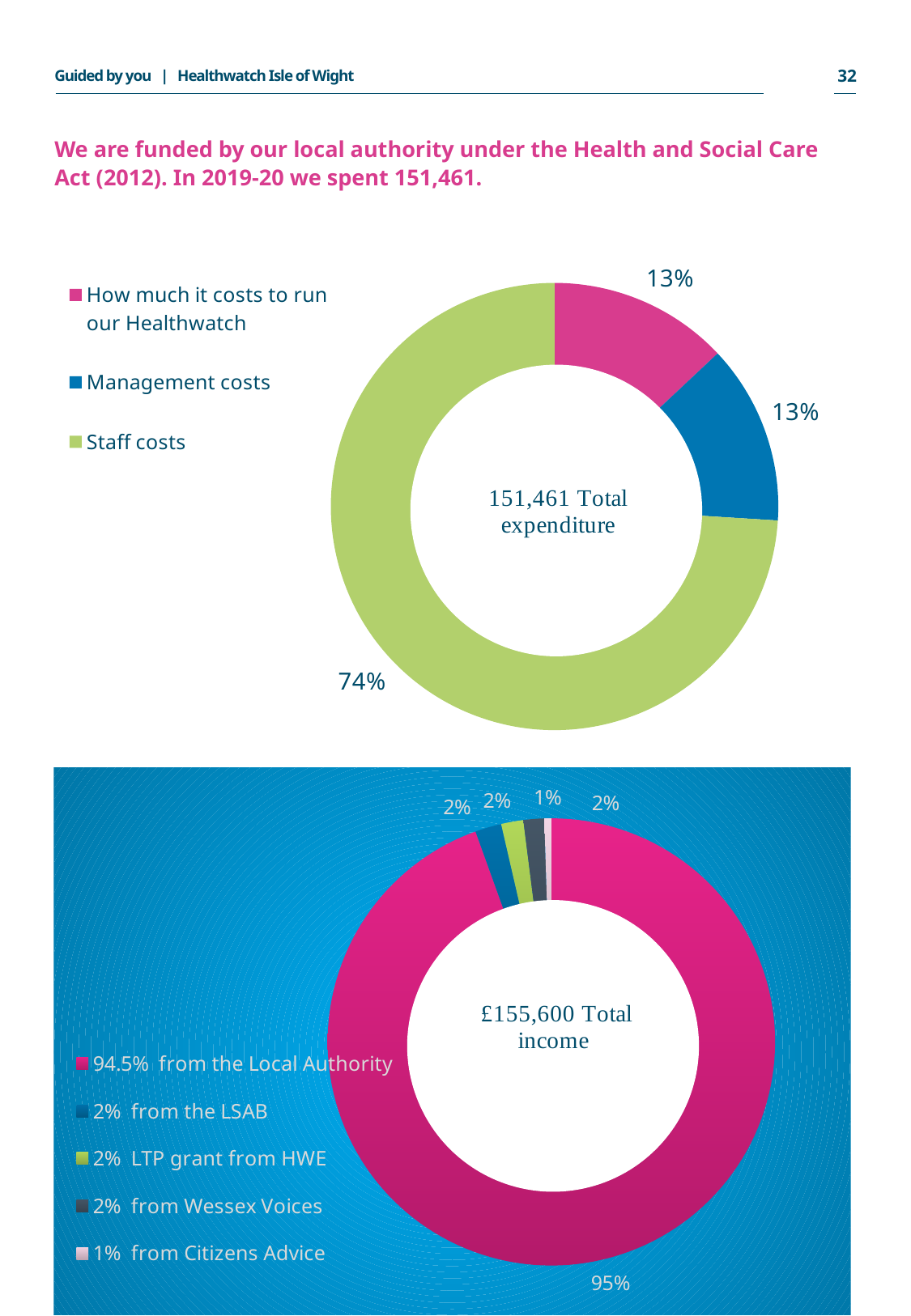
In the bottom chart (£155,600 Total income), which source provides the smallest share of income? Citizens Advice In the top chart (151,461 Total expenditure), how many categories does the legend list? 3 In the bottom chart (£155,600 Total income), which source provides the largest share of income? Local Authority In the top chart (151,461 Total expenditure), what share of expenditure is Management costs? 13% In the bottom chart (£155,600 Total income), how many income sources does the legend list? 5 In the top chart (151,461 Total expenditure), what is the difference in percentage points between Staff costs and Management costs? 61 In the bottom chart, what total income figure is shown in the centre of the doughnut? £155,600 In the bottom chart (£155,600 Total income), what share of income comes from Citizens Advice? 1% In the top chart (151,461 Total expenditure), what share of expenditure is Staff costs? 74% What kind of chart is the top chart showing total expenditure? Doughnut (pie) chart In the top chart (151,461 Total expenditure), which category has the largest share? Staff costs In the top chart, what total expenditure figure is shown in the centre of the doughnut? 151,461